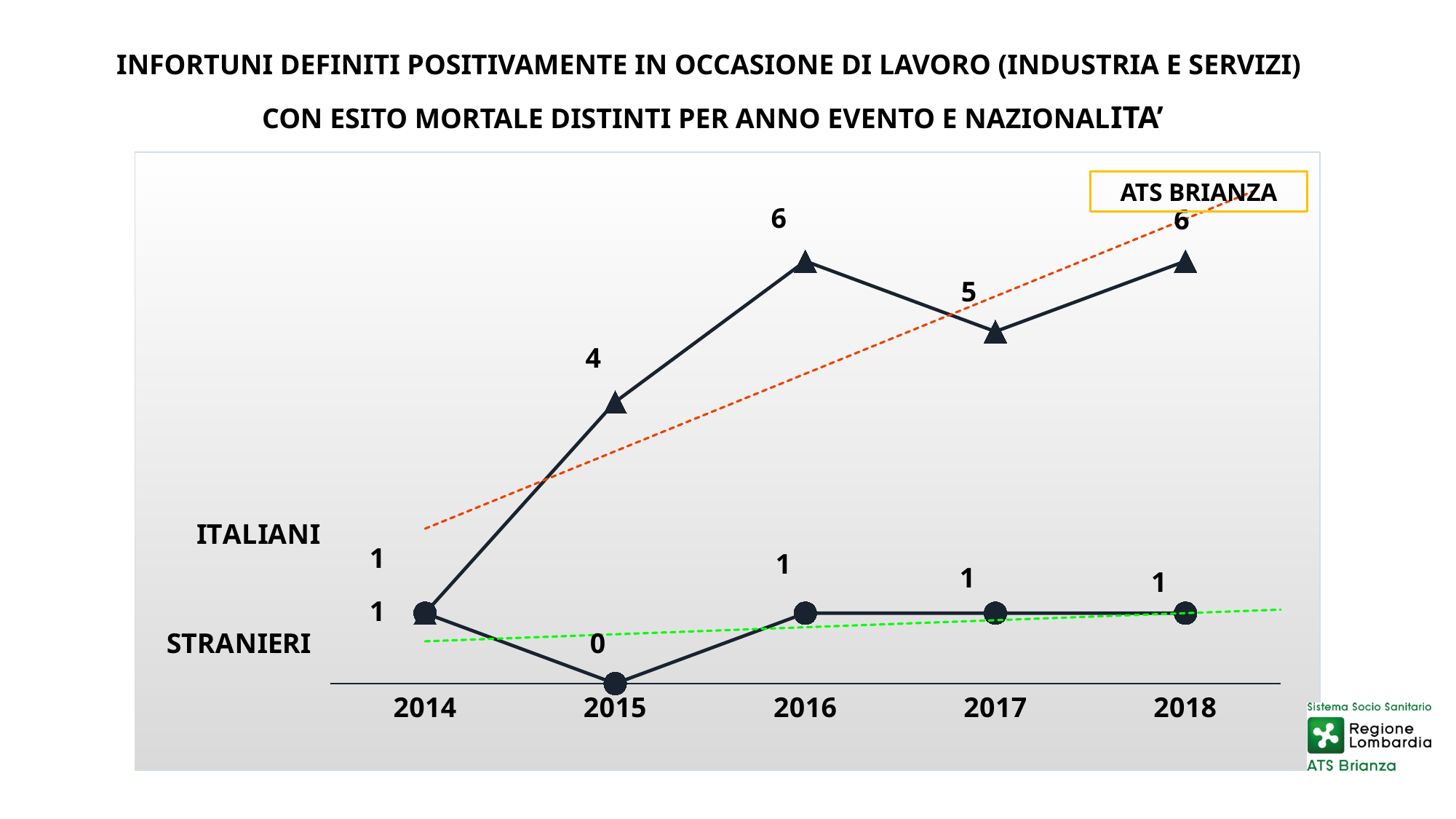
What is the difference between the ITALIANI value and the STRANIERI value in 2018? 5 What is the value for ITALIANI in 2016? 6 Which is larger in 2017, the value for ITALIANI or the value for STRANIERI? ITALIANI How many data series are plotted in the chart? 2 What is the difference between the ITALIANI value in 2016 and the ITALIANI value in 2017? 1 How many years are shown on the x axis? 5 What is the value for STRANIERI in 2015? 0 What is the value for ITALIANI in 2015? 4 What is the value for STRANIERI in 2018? 1 In which year is the value for STRANIERI lowest? 2015 In which year is the value for ITALIANI lowest? 2014 What kind of chart is shown on the slide? line chart